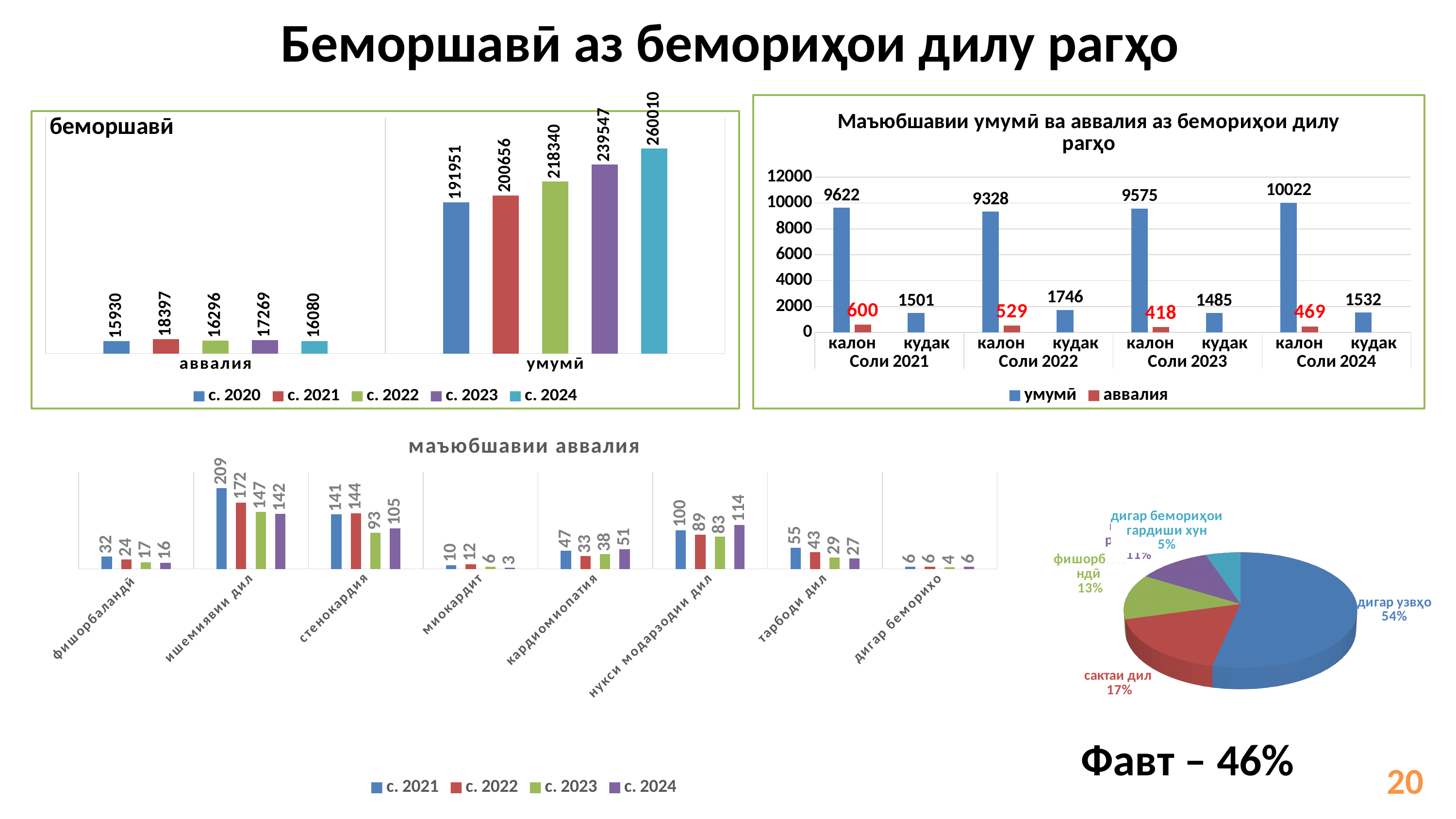
In the bottom-right pie chart, what share does 'дигар узвҳо' have? 54% In the top-right chart 'Маъюбшавии умумӣ ва аввалия аз бемориҳои дилу рагҳо', what is the 'аввалия' value for 'калон' in Соли 2023? 418 In the top-left chart titled 'беморшавӣ', what is the value for 'умумӣ' in с. 2024? 260010 In the top-right chart 'Маъюбшавии умумӣ ва аввалия аз бемориҳои дилу рагҳо', what is the 'умумӣ' value for 'калон' in Соли 2024? 10022 In the top-left chart titled 'беморшавӣ', how many series does the legend list? 5 In the bottom-left chart 'маъюбшавии аввалия', how many categories are shown on the x axis? 8 In the bottom-left chart 'маъюбшавии аввалия', what is the value for 'ишемиявии дил' in с. 2021? 209 In the top-left chart titled 'беморшавӣ', do the 'умумӣ' values rise or fall from с. 2020 to с. 2024? rise In the bottom-left chart 'маъюбшавии аввалия', which is larger for 'стенокардия': с. 2023 or с. 2024? с. 2024 In the top-right chart 'Маъюбшавии умумӣ ва аввалия аз бемориҳои дилу рагҳо', what is the difference between the 'кудак' values for Соли 2022 and Соли 2021? 245 In the top-left chart titled 'беморшавӣ', which year has the lowest 'аввалия' value? с. 2020 In the top-left chart titled 'беморшавӣ', what is the value for 'аввалия' in с. 2021? 18397